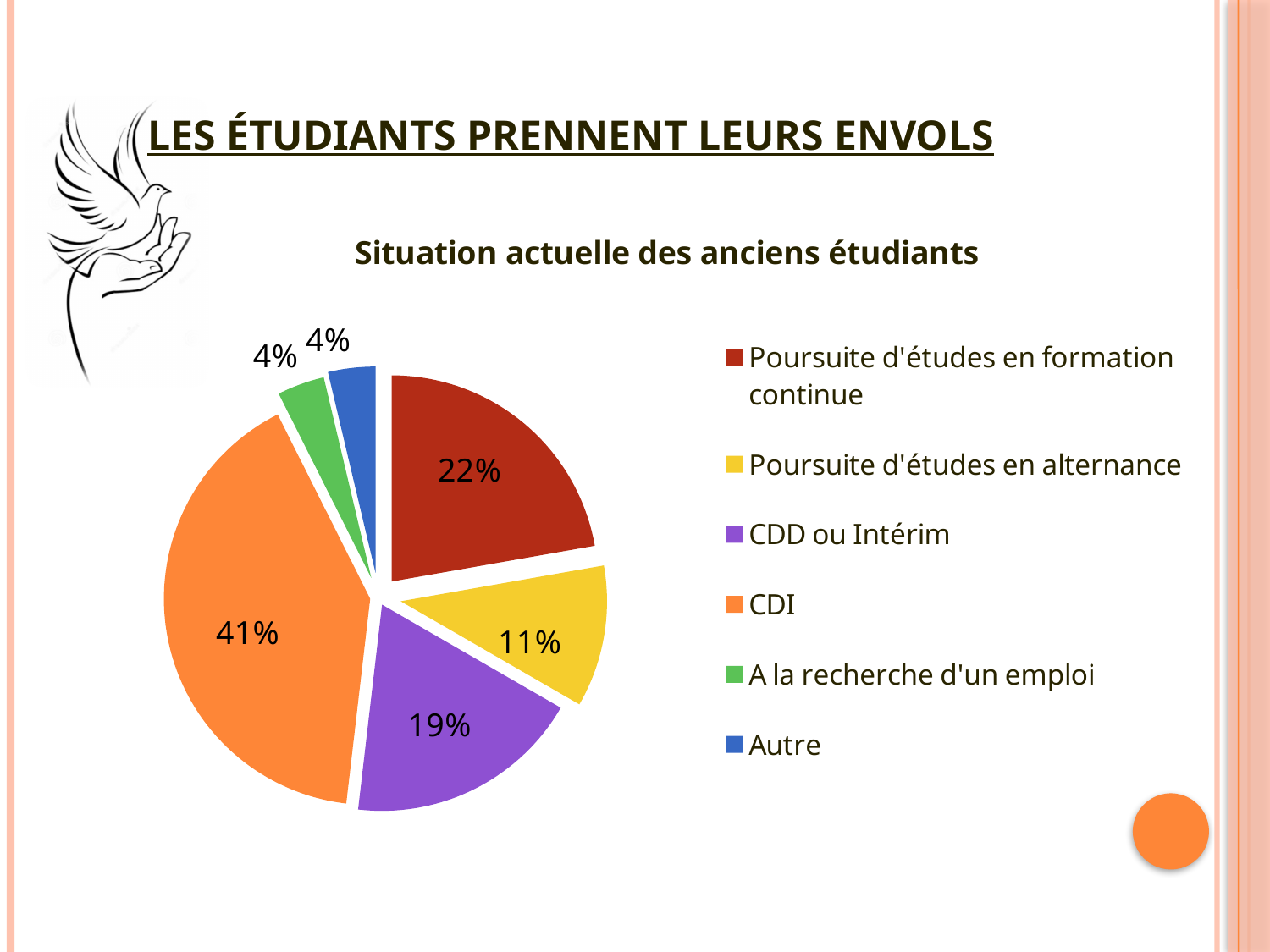
What percentage of former students are 'A la recherche d'un emploi'? 4% What is the difference in percentage points between CDI and CDD ou Intérim? 22 What colour is the slice for 'CDD ou Intérim'? Purple What is the title of the chart? Situation actuelle des anciens étudiants How many categories does the legend list? 6 What type of chart is shown on the slide? Pie chart Which is larger: the share for 'Poursuite d'études en formation continue' or the share for 'Poursuite d'études en alternance'? Poursuite d'études en formation continue Which category has the largest share of the pie? CDI What percentage of former students are in 'CDD ou Intérim'? 19% What percentage of former students are in a CDI? 41% What percentage of former students are in 'Poursuite d'études en formation continue'? 22% What percentage of former students are in 'Poursuite d'études en alternance'? 11%